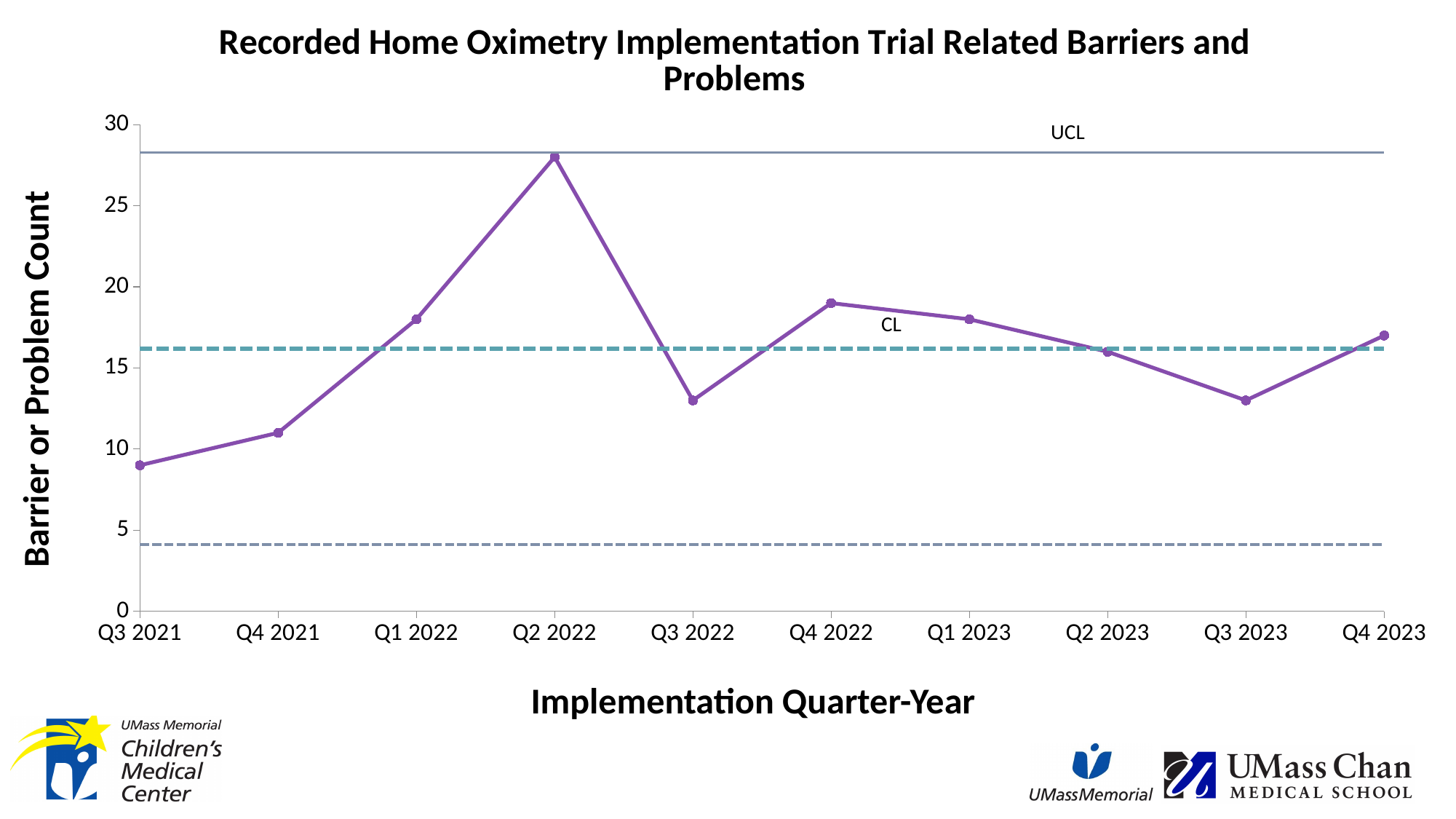
Which quarter has the highest barrier or problem count? Q2 2022 Is the value for Q4 2022 greater or less than 20? less Is the value for Q3 2022 greater or less than 10? greater How many quarter-year points are plotted on the x axis? 10 Do the values rise or fall from Q4 2022 to Q3 2023? fall Which is larger, the value for Q4 2022 or the value for Q3 2022? Q4 2022 What is the title of the x axis? Implementation Quarter-Year Which quarter has the lowest barrier or problem count? Q3 2021 Is the value for Q3 2021 greater or less than 10? less What kind of chart is shown on the slide? line chart Do the values rise or fall from Q3 2021 to Q2 2022? rise